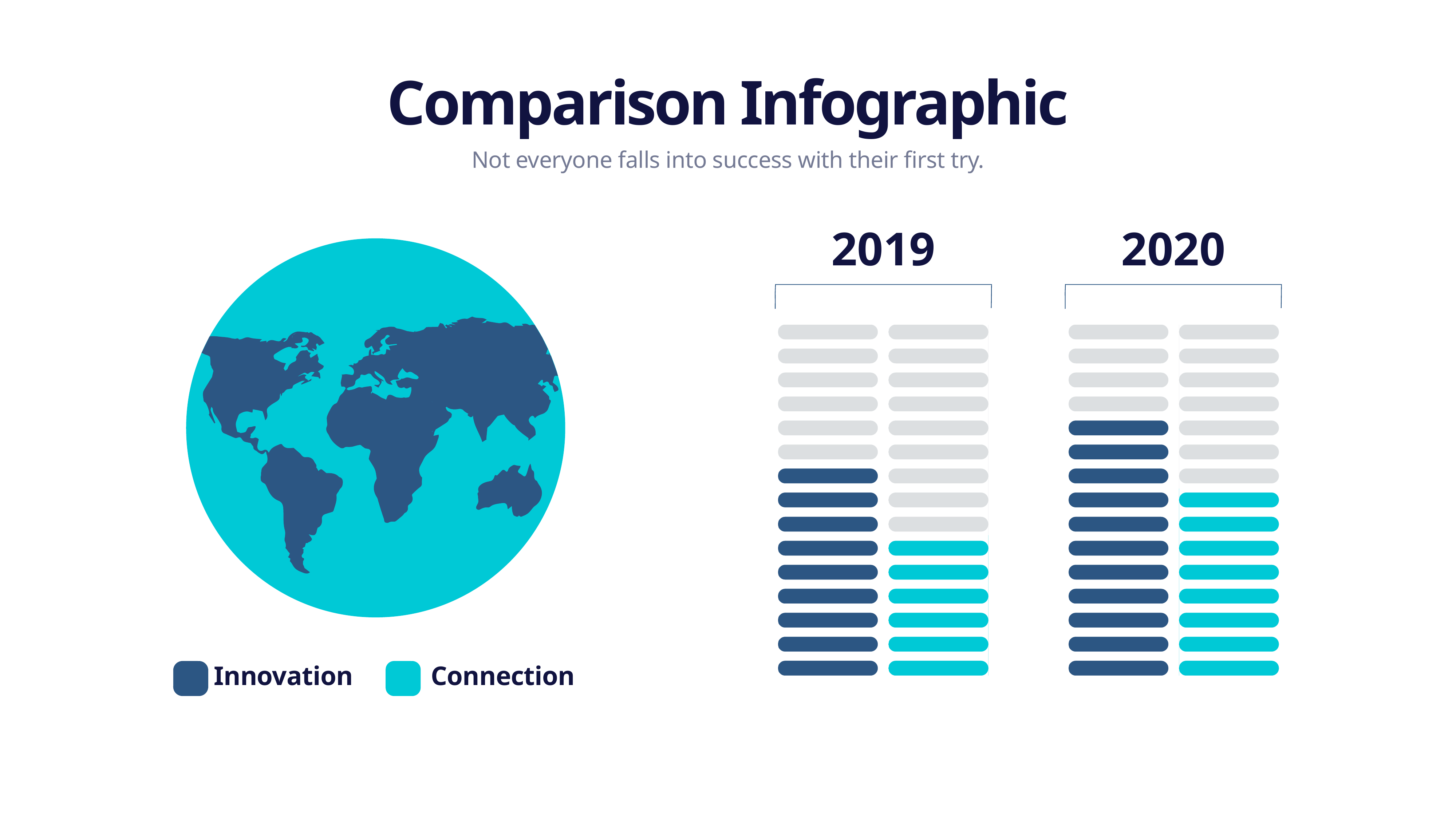
In 2019, which is larger, Innovation or Connection? Innovation Is Innovation larger in 2019 or in 2020? 2020 Which year and series combination has the lowest bar? Connection in 2019 What colour represents Connection in the legend? Cyan (turquoise) Which year and series combination has the highest bar? Innovation in 2020 Does Innovation rise or fall from 2019 to 2020? Rise In 2020, which is larger, Innovation or Connection? Innovation What are the two series named in the legend? Innovation and Connection How many series does the legend list? 2 How many years are compared in the chart? 2 What kind of chart is shown on the slide? Bar chart